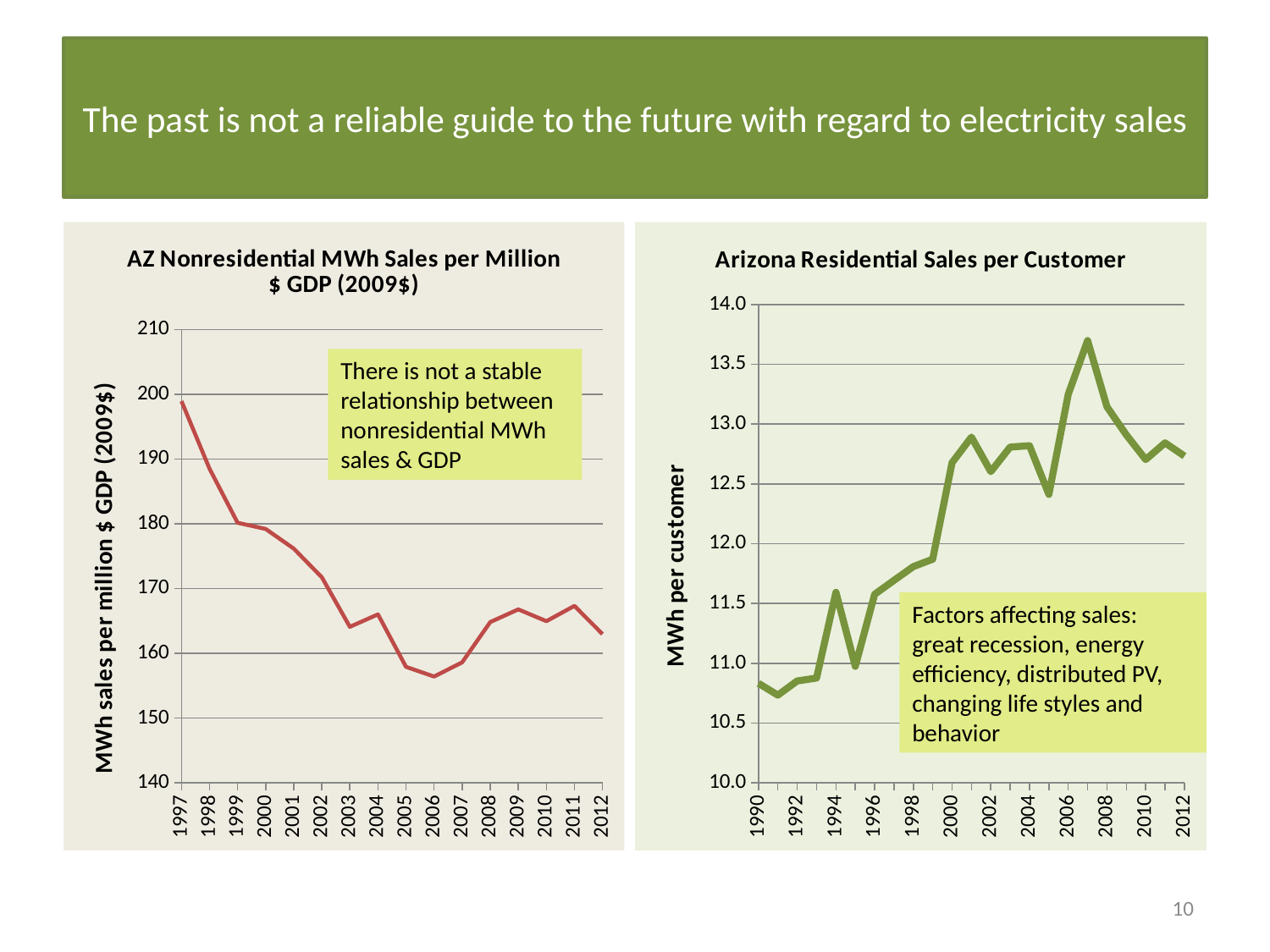
In the 'AZ Nonresidential MWh Sales per Million $ GDP (2009$)' chart, which year has the highest value? 1997 What is the y-axis label of the 'Arizona Residential Sales per Customer' chart? MWh per customer In the 'Arizona Residential Sales per Customer' chart, which year has the highest value? 2007 In the 'AZ Nonresidential MWh Sales per Million $ GDP (2009$)' chart, how many years are plotted on the x axis? 16 In the 'Arizona Residential Sales per Customer' chart, which is larger, the value for 2007 or the value for 1995? 2007 In the 'AZ Nonresidential MWh Sales per Million $ GDP (2009$)' chart, is the value for 1997 greater or less than 190? greater In the 'AZ Nonresidential MWh Sales per Million $ GDP (2009$)' chart, which year has the lowest value? 2006 In the 'Arizona Residential Sales per Customer' chart, is the value for 2007 greater or less than 13.5? greater In the 'Arizona Residential Sales per Customer' chart, which year has the lowest value? 1991 What type of chart is the 'AZ Nonresidential MWh Sales per Million $ GDP (2009$)' chart? line chart In the 'AZ Nonresidential MWh Sales per Million $ GDP (2009$)' chart, do the values overall rise or fall from 1997 to 2012? fall In the 'AZ Nonresidential MWh Sales per Million $ GDP (2009$)' chart, is the value for 2006 greater or less than 160? less